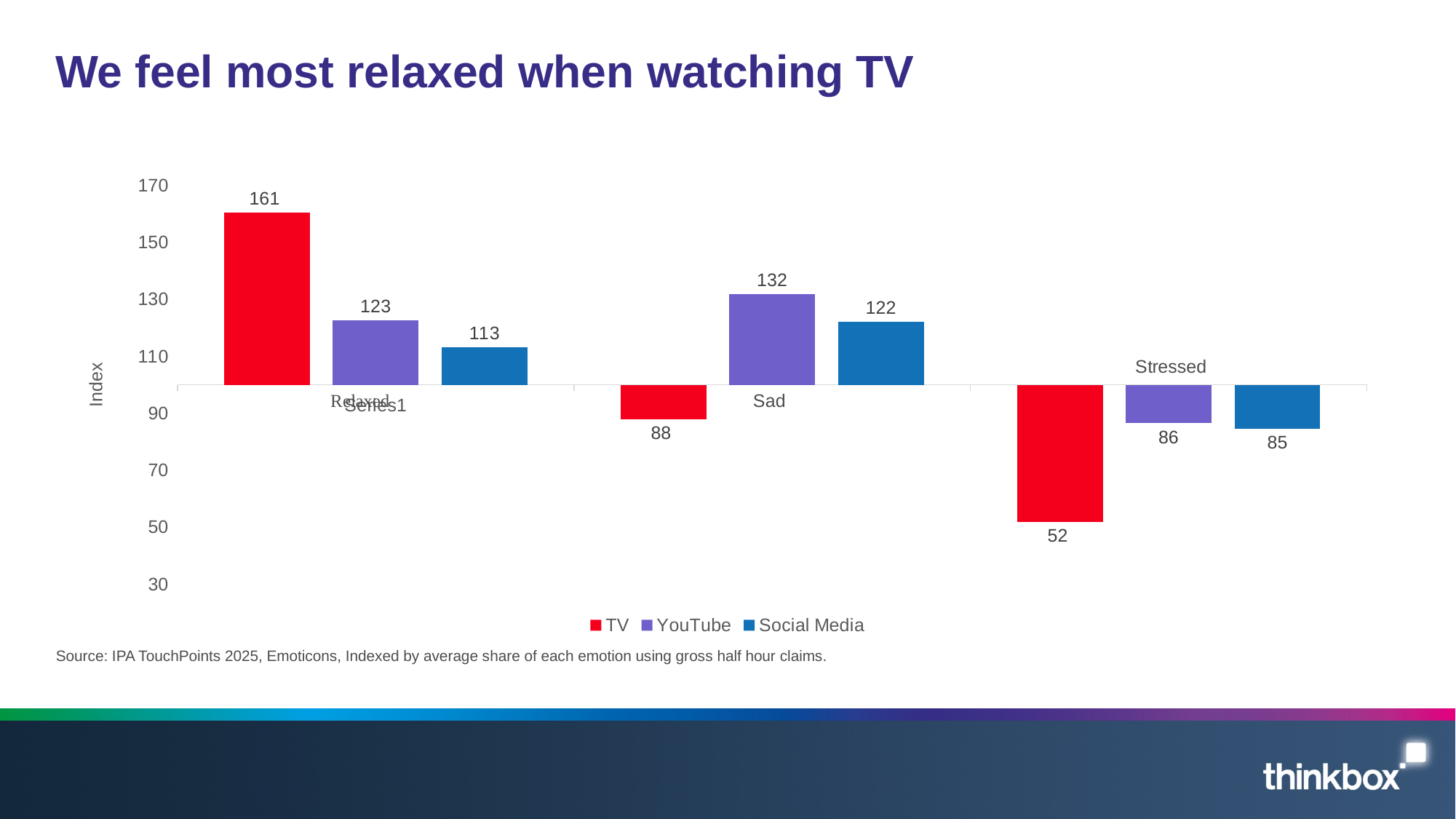
Which series has the highest index value for Relaxed? TV What is the TV index value for Stressed? 52 What kind of chart is shown on the slide? Bar chart What is the YouTube index value for Sad? 132 What is the TV index value for Relaxed? 161 Which is larger for Sad: the YouTube value or the Social Media value? YouTube How many series does the legend list? 3 How many emotion categories are shown on the x axis? 3 What is the label on the vertical axis? Index What is the difference between the TV and Social Media index values for Relaxed? 48 What is the Social Media index value for Stressed? 85 Which series has the lowest index value for Sad? TV